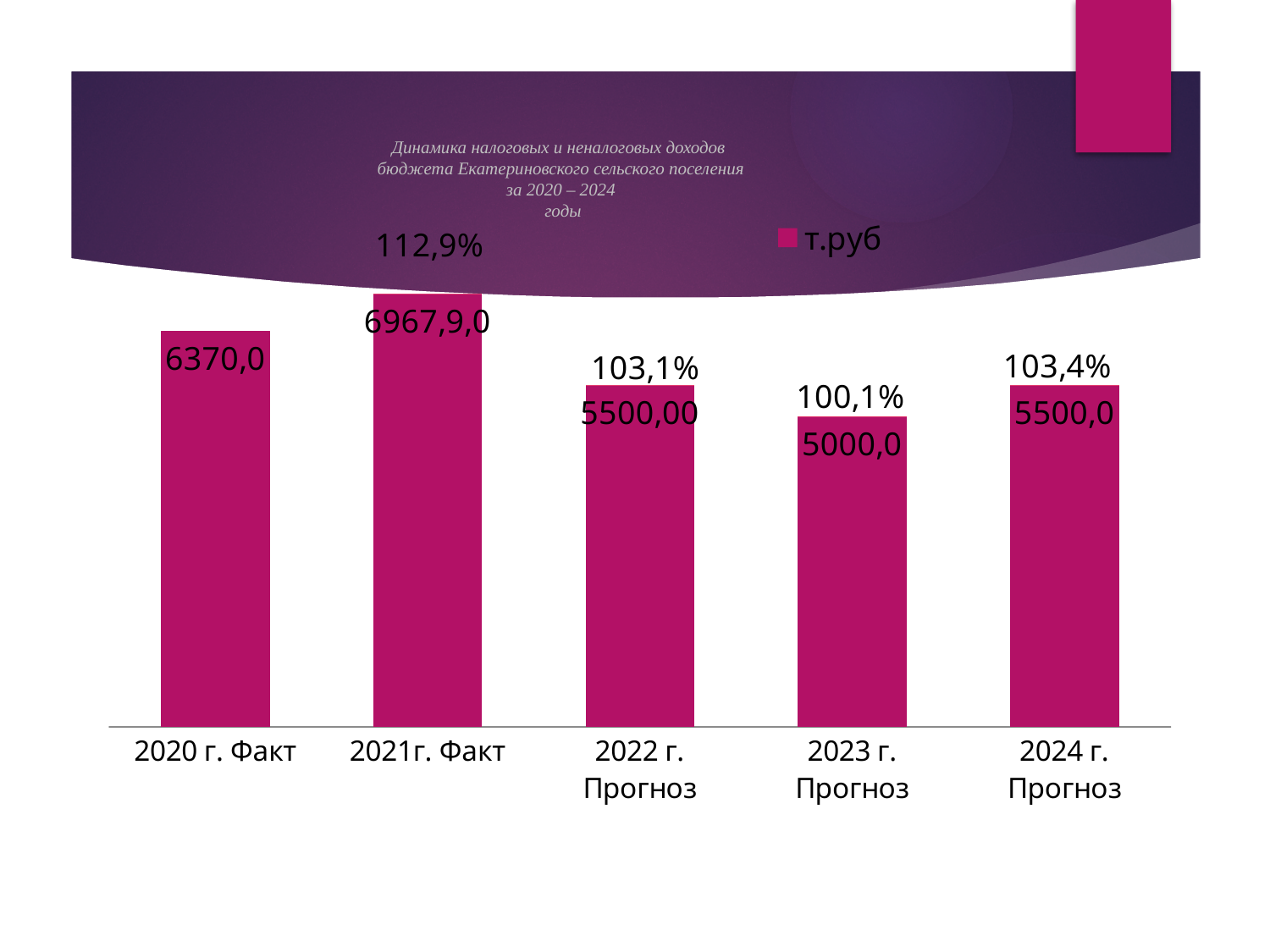
What is the value for 2020 г. Факт? 6370,0 What is the value for 2023 г. Прогноз? 5000,0 How many series does the legend list? 1 Which category has the highest bar? 2021г. Факт What type of chart is shown on the slide? bar chart Which is larger, the value for 2020 г. Факт or 2022 г. Прогноз? 2020 г. Факт How many categories (years) are shown on the x axis? 5 What is the difference between the values for 2020 г. Факт and 2023 г. Прогноз? 1370,0 What is the legend entry for the series? т.руб What is the value for 2024 г. Прогноз? 5500,0 What percentage label is shown above the 2021г. Факт bar? 112,9% Which category has the lowest bar? 2023 г. Прогноз